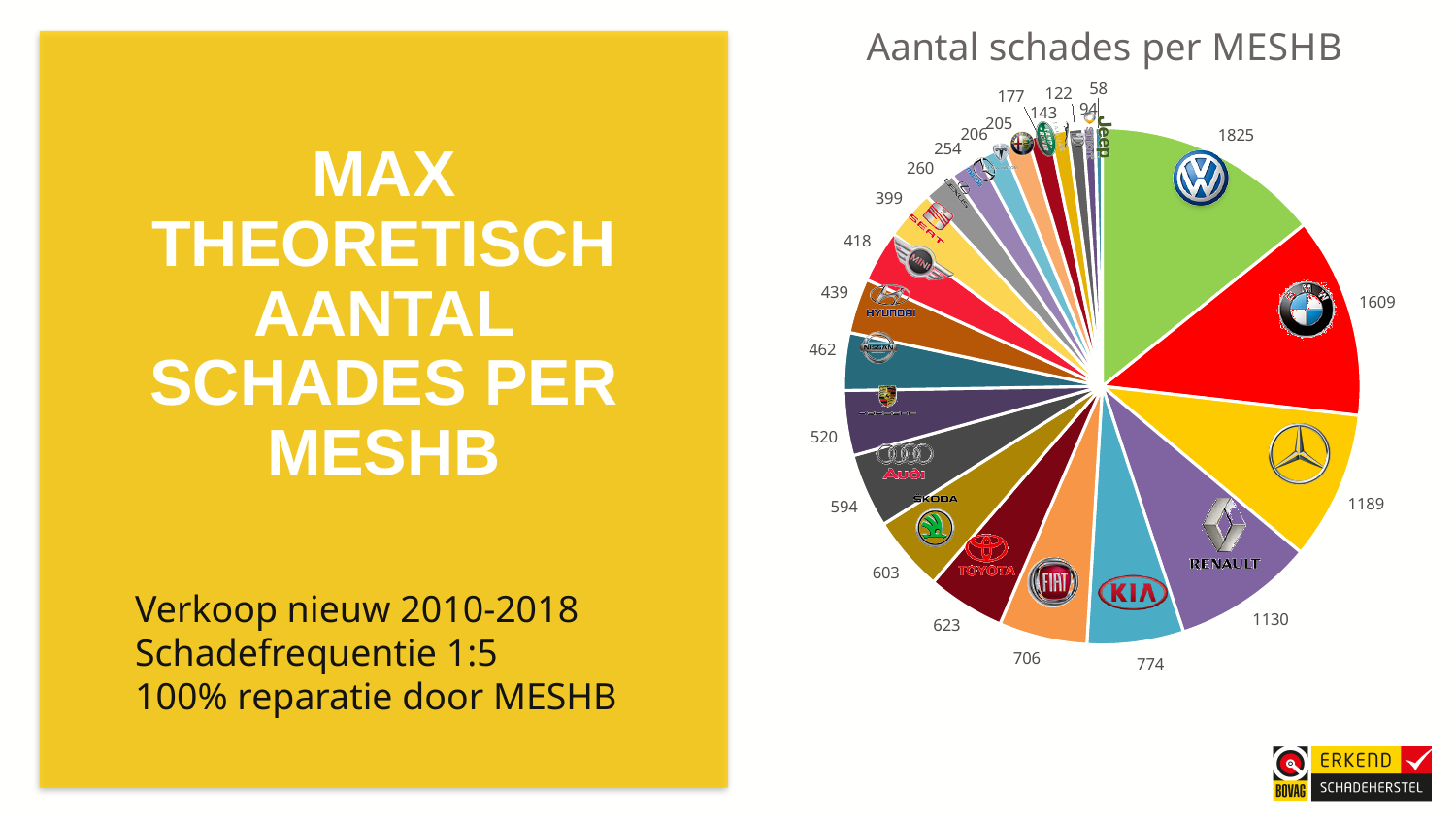
What is the value for the Toyota slice? 623 What is the difference between the VW slice (1825) and the BMW slice (1609)? 216 What is the value for the BMW slice? 1609 What is the largest value shown in the pie chart? 1825 How many slices does the pie chart have? 23 Which slice is larger, KIA or Fiat? KIA What is the title of the chart? Aantal schades per MESHB What is the difference between the Mercedes slice (1189) and the Renault slice (1130)? 59 What is the value for the Renault slice? 1130 Which brand has the largest slice in the pie chart? Volkswagen (VW) What kind of chart is shown on the slide? pie chart What is the smallest value shown in the pie chart? 58